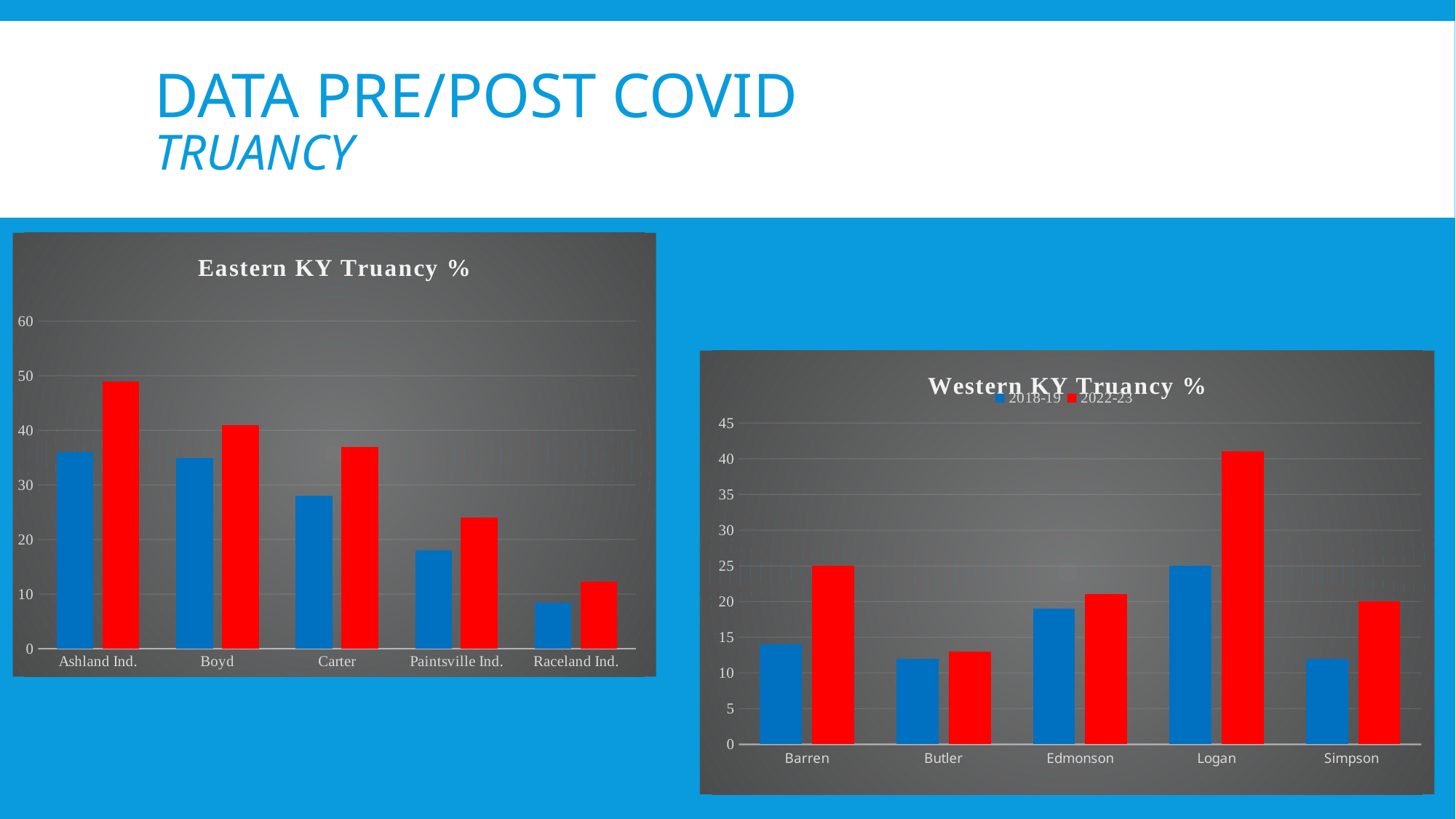
In the Western KY Truancy % chart, is the 2022-23 value for Logan greater or less than 40? greater In the Western KY Truancy % chart, is the 2018-19 value for Barren greater or less than 15? less How many series does the legend of the Western KY Truancy % chart list? 2 In the Eastern KY Truancy % chart, which category has the highest red bar? Ashland Ind. In the Western KY Truancy % chart, which is larger for Simpson: the 2018-19 value or the 2022-23 value? 2022-23 In the Eastern KY Truancy % chart, which category has the lowest blue bar? Raceland Ind. In the Eastern KY Truancy % chart, is the red bar for Ashland Ind. greater or less than 40? greater How many categories are shown on the x axis of the Western KY Truancy % chart? 5 In the Eastern KY Truancy % chart, which is larger: the blue bar for Carter or the blue bar for Paintsville Ind.? Carter What kind of chart is the Eastern KY Truancy % chart? bar chart In the Western KY Truancy % chart, which category has the highest 2022-23 value? Logan What are the two legend entries in the Western KY Truancy % chart? 2018-19 and 2022-23